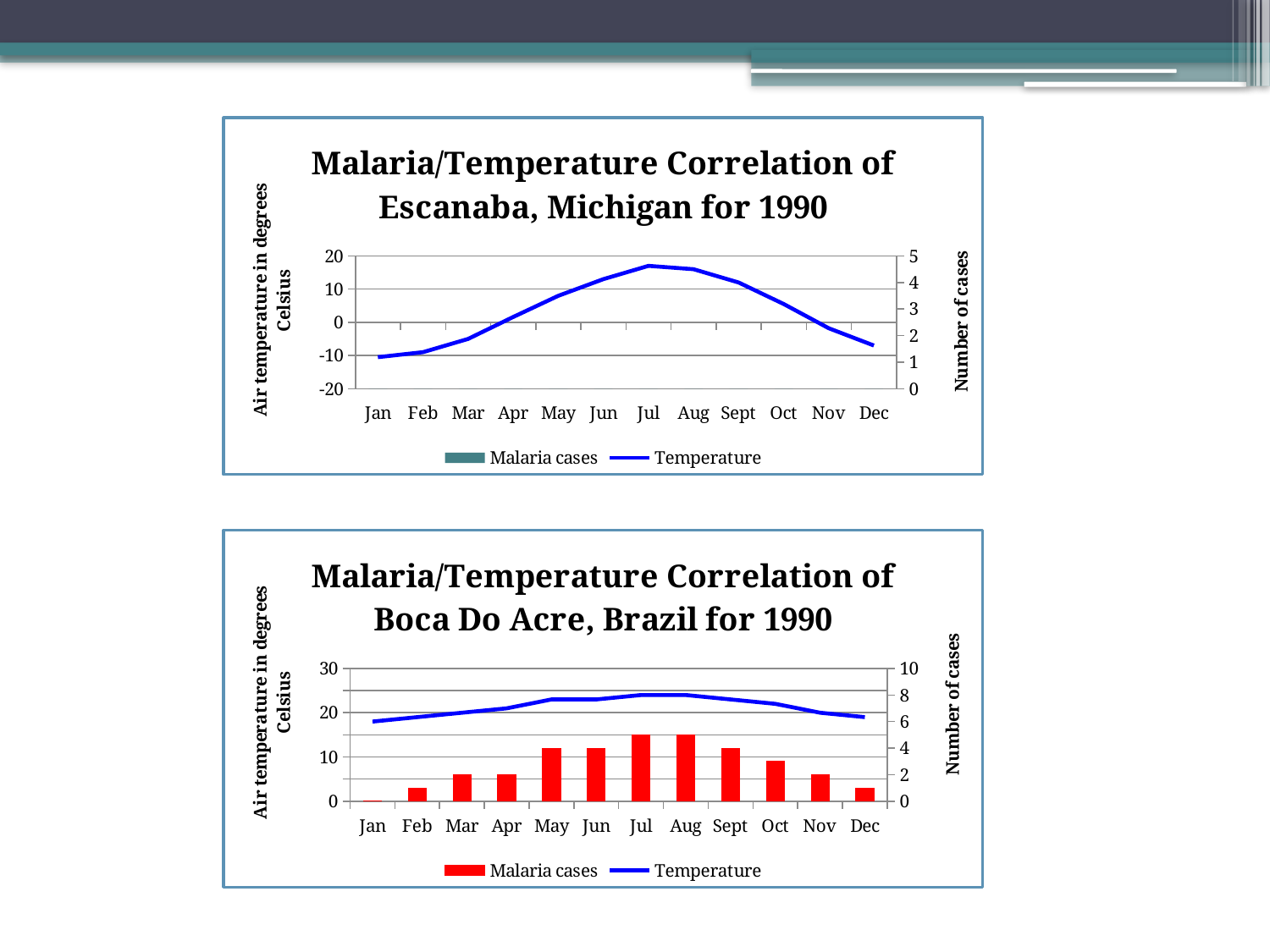
In the top chart (Escanaba, Michigan), is the temperature for Jul greater or less than 10? greater In the bottom chart (Boca Do Acre, Brazil), what kind of chart is used for the Malaria cases series? bar chart In the bottom chart (Boca Do Acre, Brazil), what is the number of malaria cases in May? 4 In the top chart (Escanaba, Michigan), is the temperature for Jan greater or less than 0? less In the top chart (Escanaba, Michigan), which month has the highest temperature? Jul In the bottom chart (Boca Do Acre, Brazil), what colour are the Malaria cases bars? red In the bottom chart (Boca Do Acre, Brazil), what is the number of malaria cases in Mar? 2 In the top chart (Escanaba, Michigan), does the temperature rise or fall from Jan to Jul? rise In the top chart (Escanaba, Michigan), how many series does the legend list? 2 In the bottom chart (Boca Do Acre, Brazil), is the number of malaria cases in Jul greater or less than 4? greater In the bottom chart (Boca Do Acre, Brazil), which has more malaria cases, Feb or May? May In the top chart (Escanaba, Michigan), how many months are shown on the x axis? 12